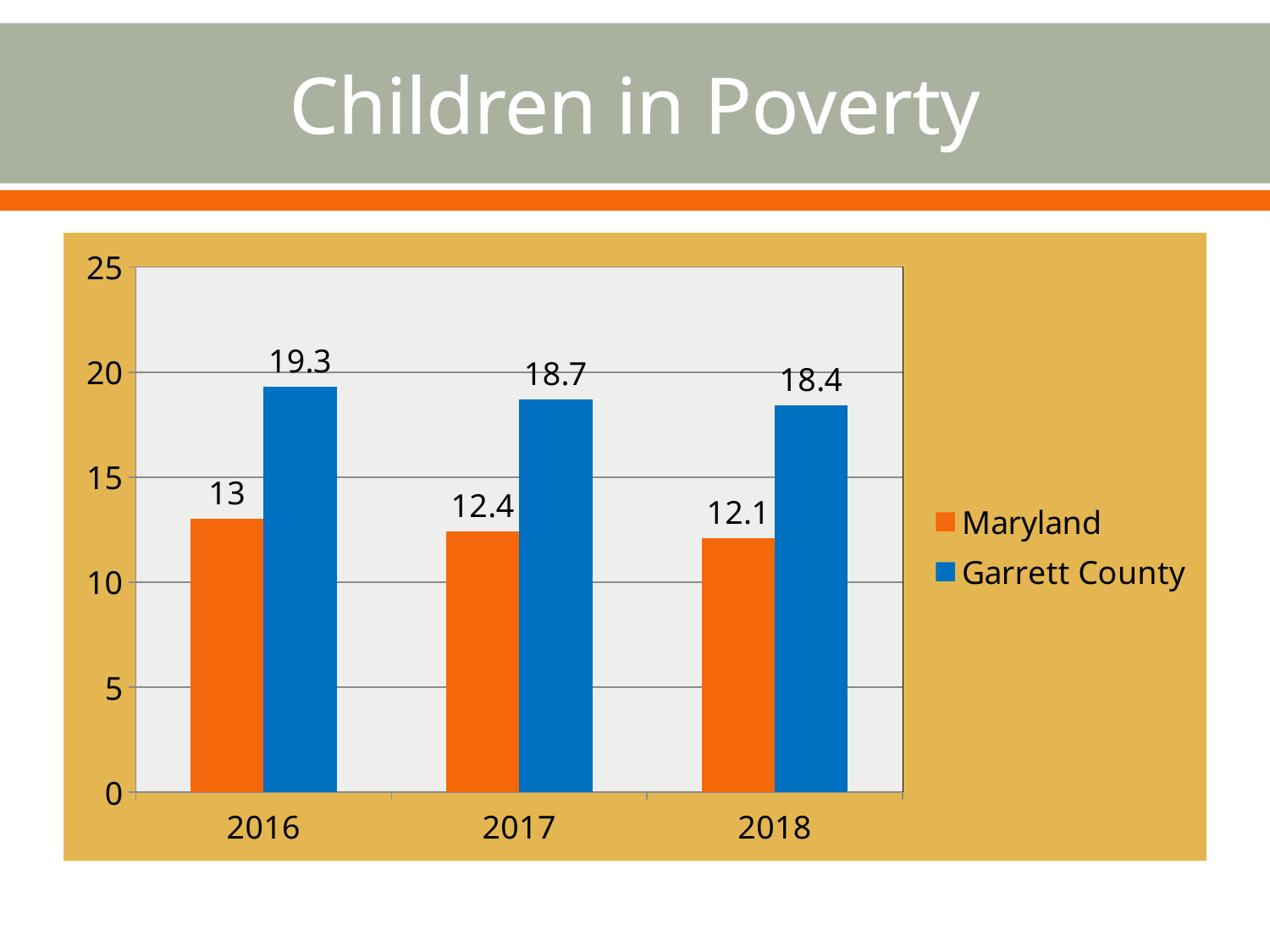
What is the difference between the Garrett County and Maryland values in 2016? 6.3 What is the difference between the Maryland values in 2016 and 2018? 0.9 In which year is the Maryland value lowest? 2018 How many years are shown on the x axis? 3 Do the Garrett County values rise or fall from 2016 to 2018? Fall What is the value for Maryland in 2016? 13 What is the value for Garrett County in 2017? 18.7 What kind of chart is shown on the slide? Bar chart In which year is the Garrett County value highest? 2016 Which is larger in 2017, the Maryland value or the Garrett County value? Garrett County How many series does the legend list? 2 What is the value for Garrett County in 2018? 18.4